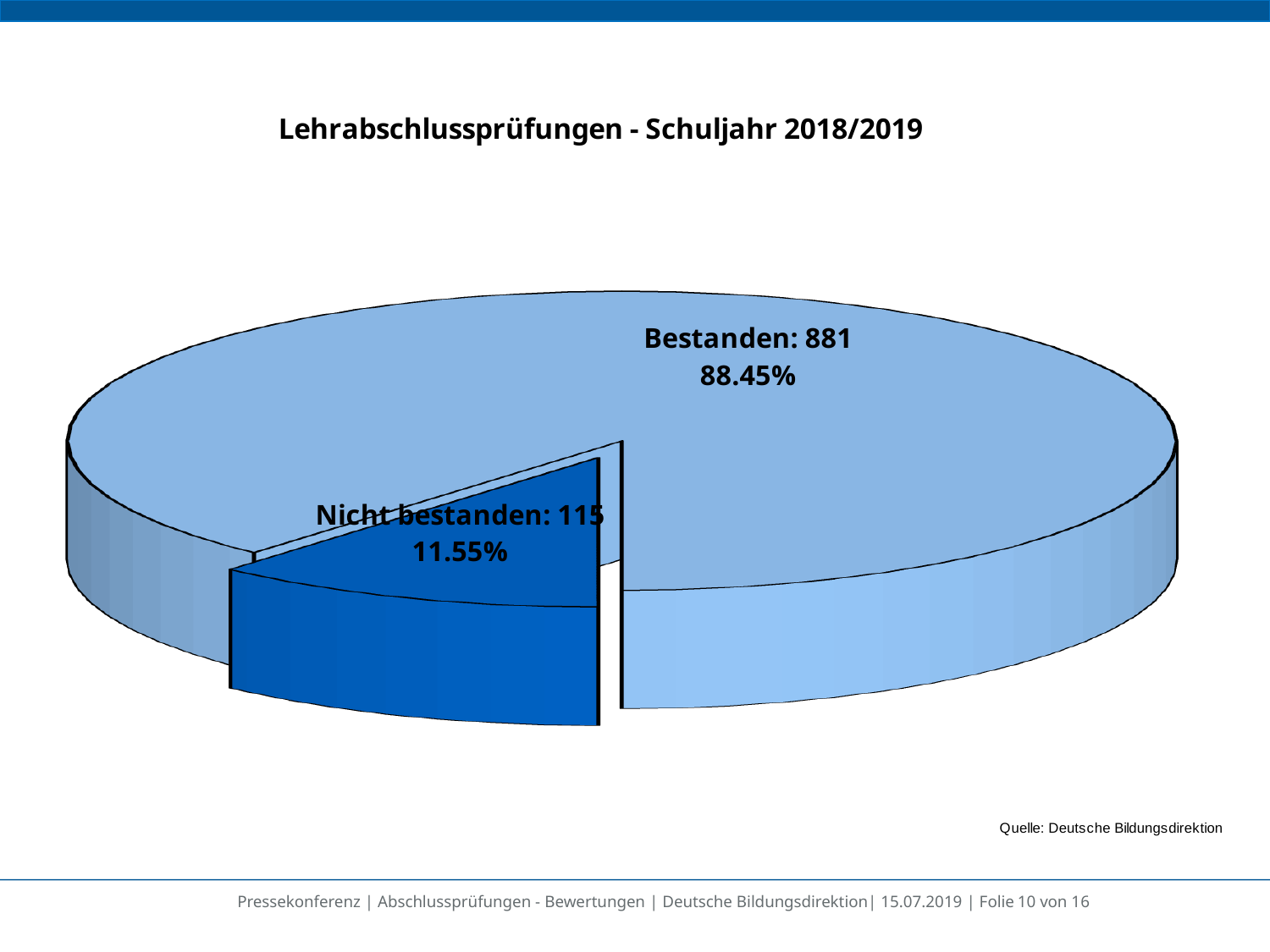
Which slice of the pie is the smallest? Nicht bestanden How many candidates passed (Bestanden) according to the chart? 881 Which is larger, the Bestanden slice or the Nicht bestanden slice? Bestanden Which slice of the pie is the largest? Bestanden What share of the pie does the Bestanden slice represent? 88.45% How many candidates did not pass (Nicht bestanden) according to the chart? 115 What is the title of the chart? Lehrabschlussprüfungen - Schuljahr 2018/2019 What is the total number of candidates represented in the pie chart? 996 What share of the pie does the Nicht bestanden slice represent? 11.55% How many slices does the pie chart have? 2 What type of chart is shown on the slide? Pie chart What is the difference between the number of Bestanden and Nicht bestanden candidates? 766